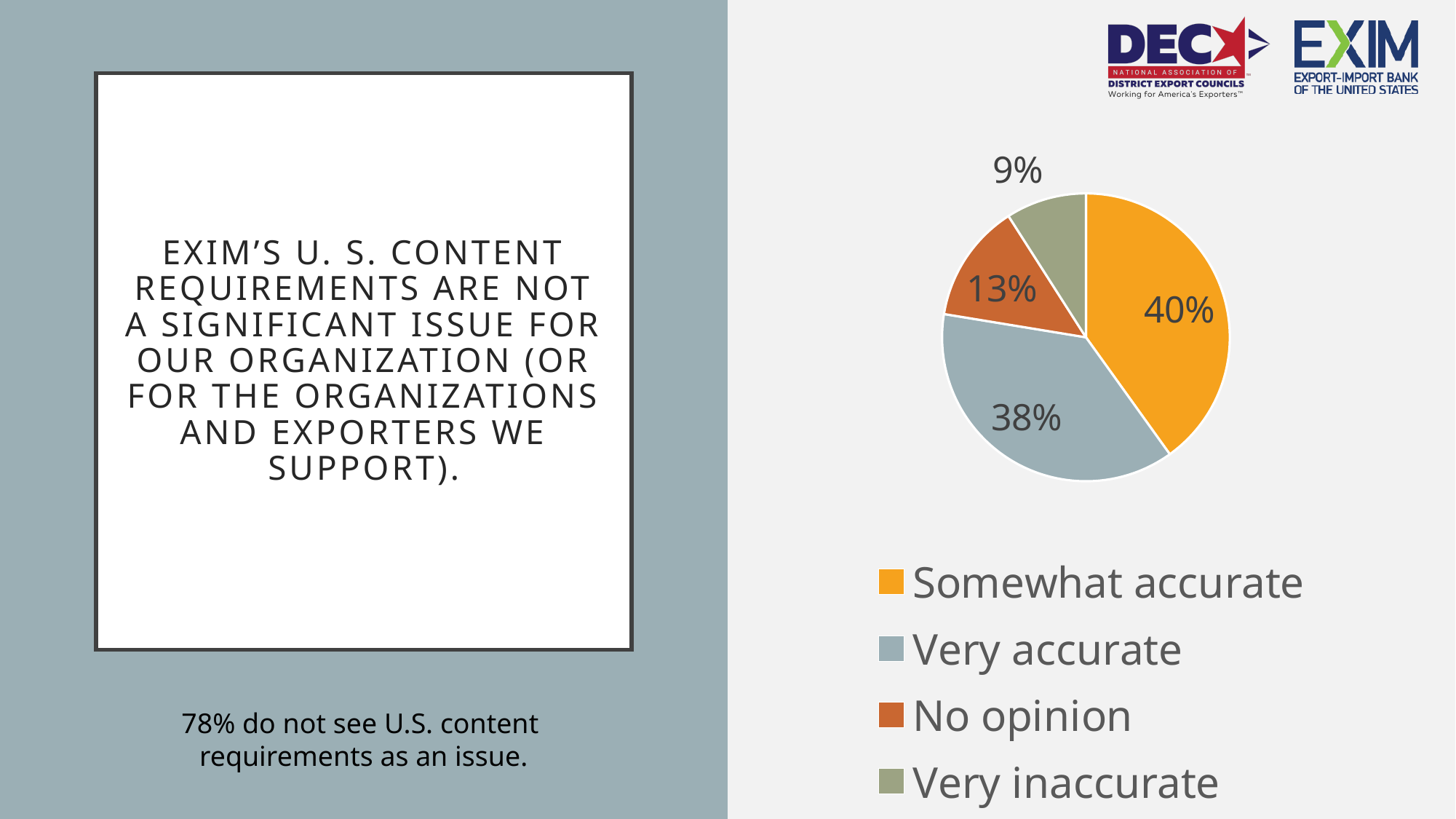
What is the difference in percentage points between "No opinion" and "Very inaccurate"? 4 What percentage of respondents answered "No opinion"? 13% What percentage of respondents answered "Somewhat accurate"? 40% What percentage of respondents answered "Very inaccurate"? 9% Which response category has the smallest share of the pie? Very inaccurate What colour is the "Very accurate" slice in the pie chart? Grey-blue What percentage of respondents answered "Very accurate"? 38% What kind of chart is shown on the slide? Pie chart What is the difference in percentage points between "Somewhat accurate" and "Very inaccurate"? 31 Which response category has the largest share of the pie? Somewhat accurate How many categories does the pie chart show? 4 Which is larger, the share for "No opinion" or the share for "Very inaccurate"? No opinion